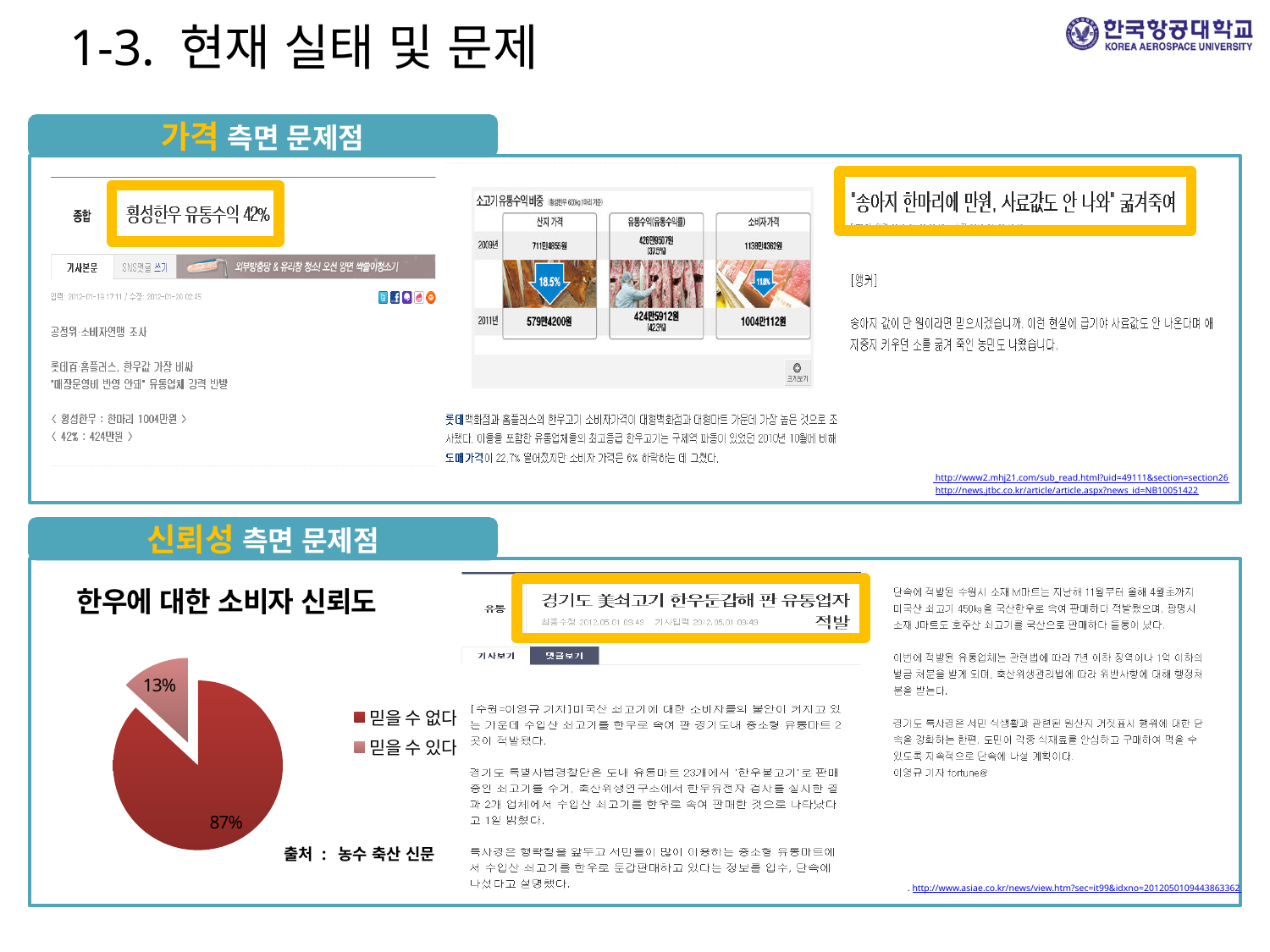
In the "한우에 대한 소비자 신뢰도" pie chart, which is larger: 믿을 수 있다 or 믿을 수 없다? 믿을 수 없다 In the "한우에 대한 소비자 신뢰도" pie chart, what is the difference in percentage points between 믿을 수 없다 and 믿을 수 있다? 74 What is the title of the pie chart on the slide? 한우에 대한 소비자 신뢰도 How many entries does the legend of the "한우에 대한 소비자 신뢰도" pie chart list? 2 What kind of chart is the "한우에 대한 소비자 신뢰도" chart? pie chart What source is cited below the "한우에 대한 소비자 신뢰도" pie chart? 농수 축산 신문 In the "한우에 대한 소비자 신뢰도" pie chart, what share is labelled for 믿을 수 없다? 87% In the "한우에 대한 소비자 신뢰도" pie chart, which slice is the smallest? 믿을 수 있다 How many slices does the "한우에 대한 소비자 신뢰도" pie chart have? 2 In the "한우에 대한 소비자 신뢰도" pie chart, what share is labelled for 믿을 수 있다? 13% In the "한우에 대한 소비자 신뢰도" pie chart, which slice is the largest? 믿을 수 없다